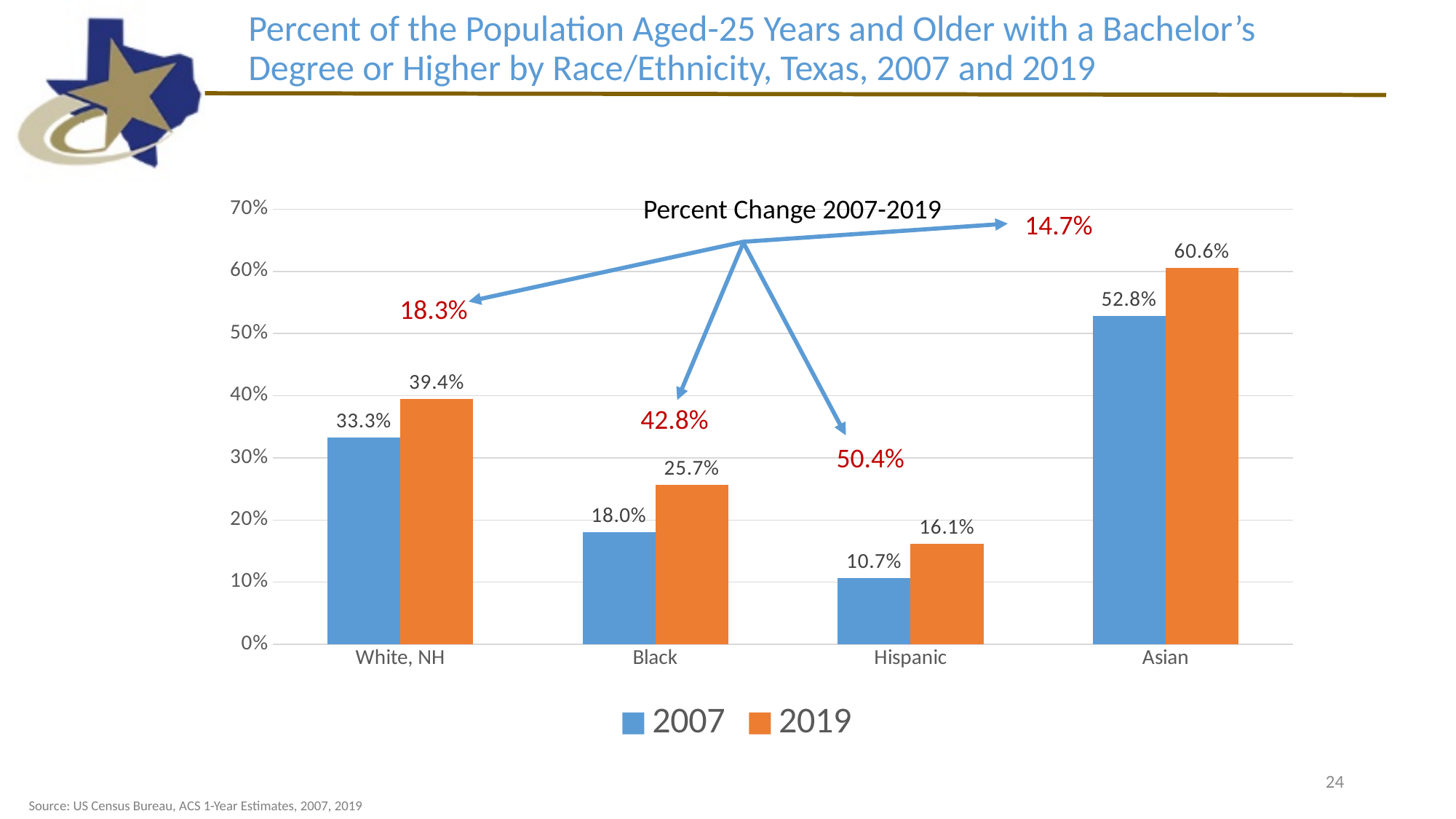
What is the value for Asian in 2019? 60.6% How many race/ethnicity categories are shown on the x axis? 4 Which category has the lowest value in 2019? Hispanic Which category has the highest value in 2007? Asian What is the difference between the 2019 and 2007 values for White, NH? 6.1% Which is larger: the 2019 value for Black or the 2007 value for White, NH? 2007 value for White, NH What percent change from 2007 to 2019 is annotated for Hispanic? 50.4% What kind of chart is shown on the slide? Bar chart What is the value for Hispanic in 2007? 10.7% Which colour represents the 2019 series in the legend? Orange How many series does the legend list? 2 What is the value for Black in 2019? 25.7%